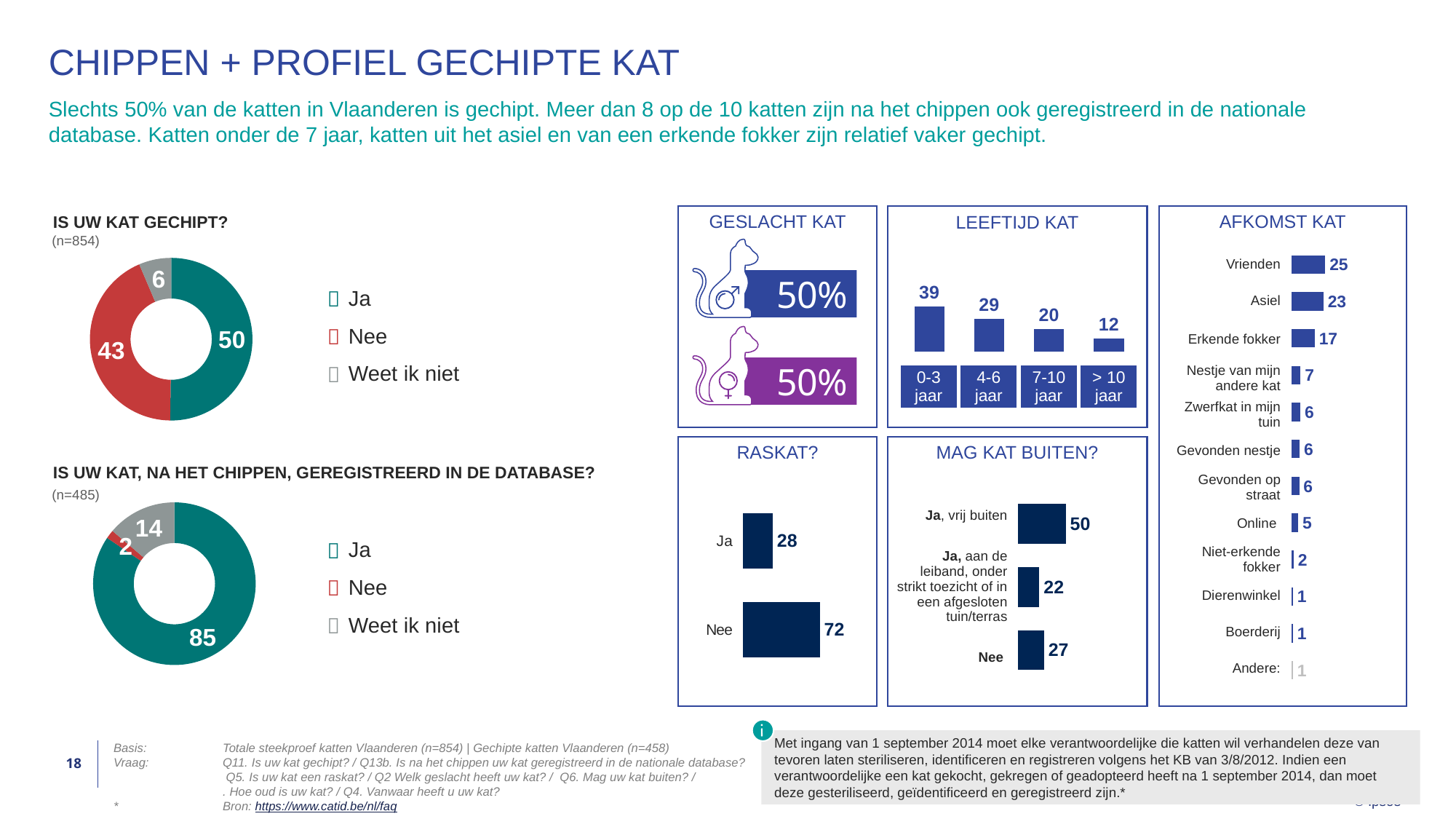
In the "AFKOMST KAT" chart, which is larger, "Asiel" or "Online"? Asiel How many categories does the "LEEFTIJD KAT" chart show? 4 In the "IS UW KAT GECHIPT?" donut chart, what is the value for "Ja"? 50 What kind of chart is the "AFKOMST KAT" chart? bar chart In the "RASKAT?" chart, what is the difference between "Nee" and "Ja"? 44 In the "IS UW KAT GECHIPT?" donut chart, what is the value for "Weet ik niet"? 6 In the "MAG KAT BUITEN?" chart, which category has the lowest value? Ja, aan de leiband, onder strikt toezicht of in een afgesloten tuin/terras In the "IS UW KAT, NA HET CHIPPEN, GEREGISTREERD IN DE DATABASE?" donut chart, which category has the highest value? Ja In the "IS UW KAT, NA HET CHIPPEN, GEREGISTREERD IN DE DATABASE?" donut chart, what is the difference between "Ja" and "Weet ik niet"? 71 In the "LEEFTIJD KAT" chart, do the values rise or fall from "0-3 jaar" to "> 10 jaar"? fall In the "LEEFTIJD KAT" chart, what is the value for "0-3 jaar"? 39 In the "AFKOMST KAT" chart, what is the value for "Erkende fokker"? 17